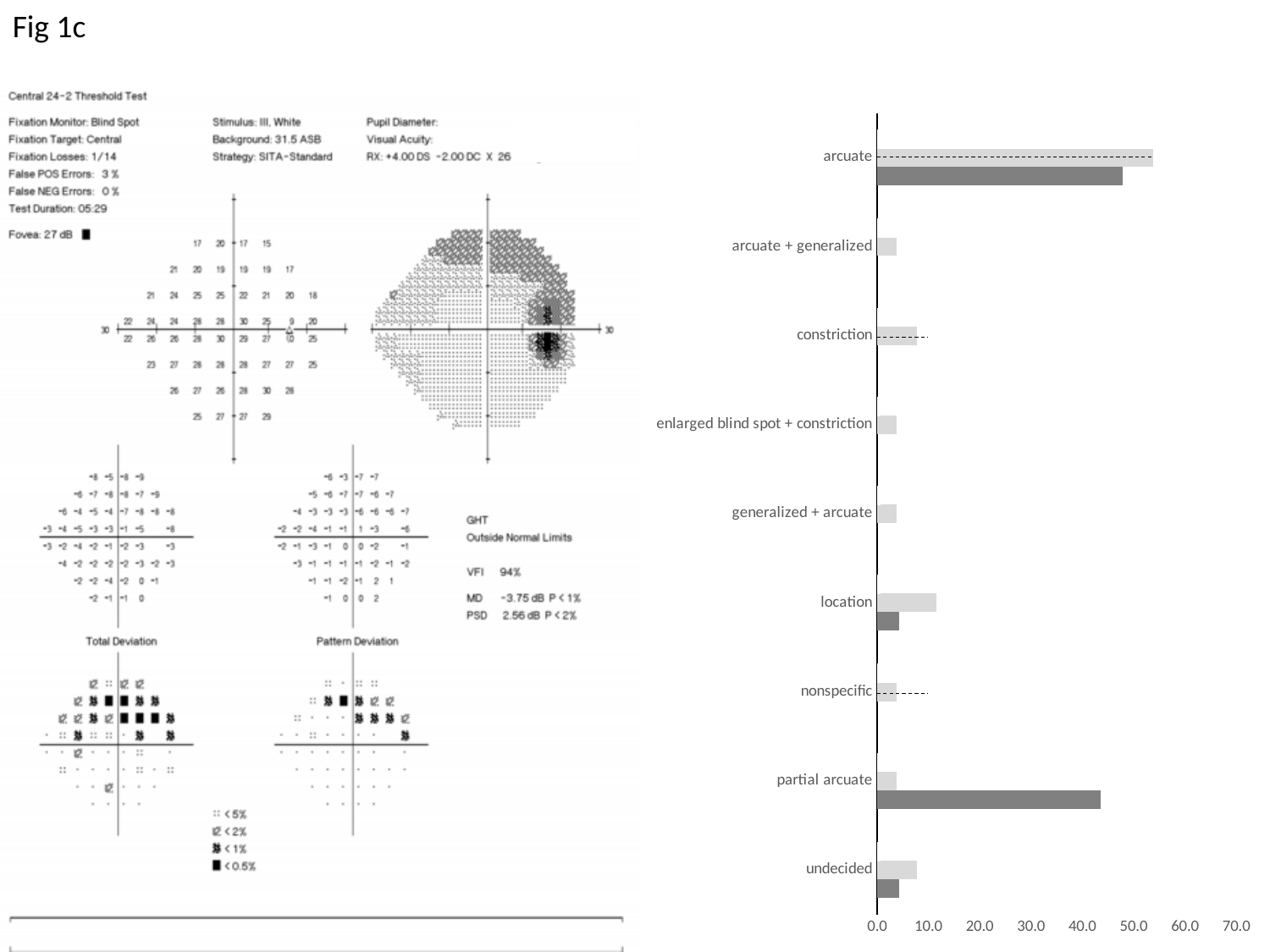
What is the highest value shown on the horizontal axis of the bar chart? 70.0 What kind of chart is shown on the right side of the slide? bar chart In the bar chart, which category has the longest light gray bar? arcuate In the bar chart, which is larger for location: the light gray bar or the dark gray bar? the light gray bar In the bar chart, which category has a longer dark gray bar: partial arcuate or undecided? partial arcuate In the bar chart, is the light gray value for constriction greater or less than 10.0? less In the bar chart, which category has the longest dark gray bar? arcuate In the bar chart, is the light gray value for location greater or less than 20.0? less In the bar chart, which is larger for partial arcuate: the light gray bar or the dark gray bar? the dark gray bar How many categories are listed on the vertical axis of the bar chart? 9 In the bar chart, is the light gray value for arcuate greater or less than 50.0? greater